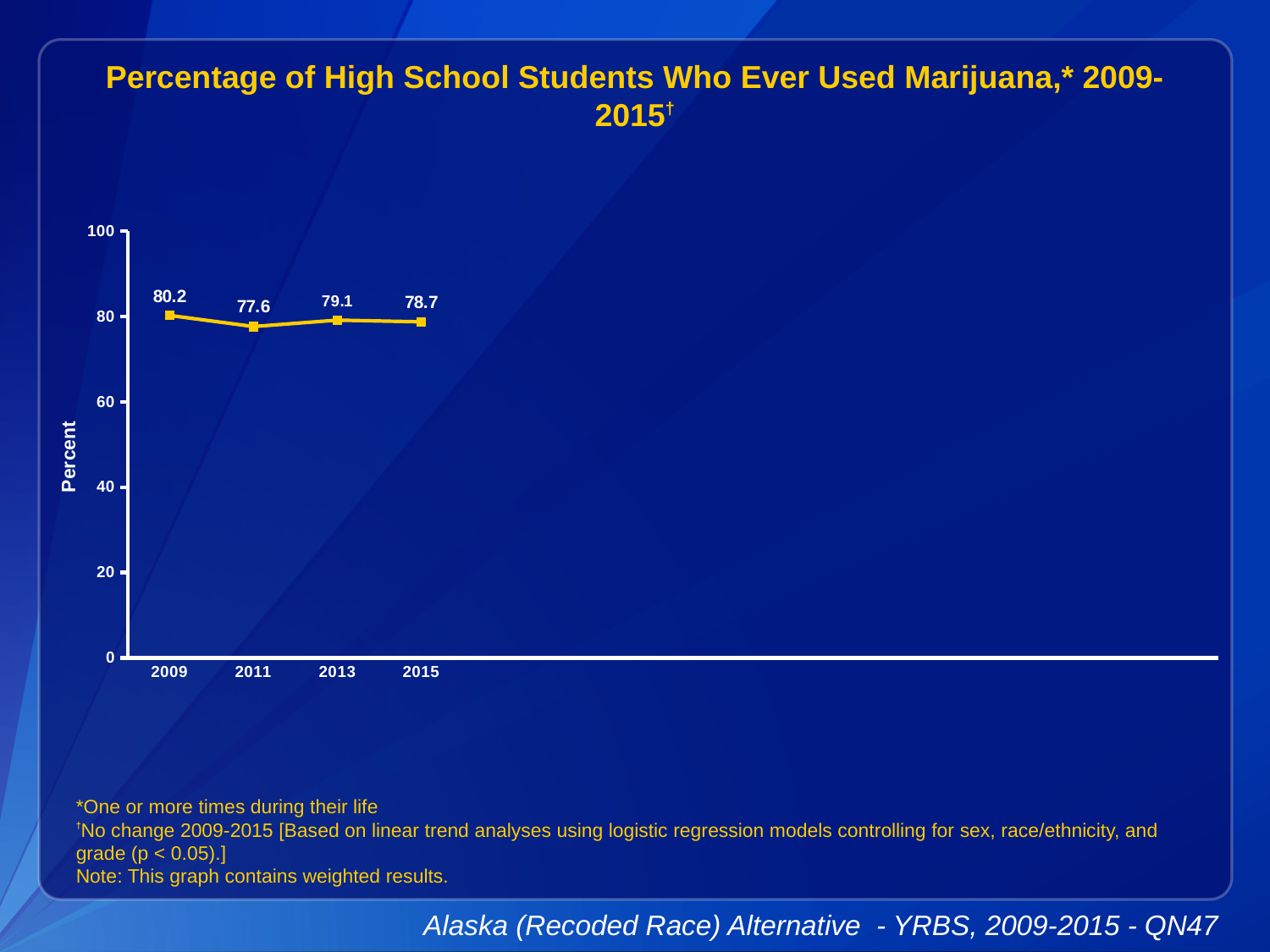
How many years are plotted on the chart? 4 What is the value for 2015? 78.7 Which year has the lowest value? 2011 What is the value for 2013? 79.1 Is the value for 2011 greater or less than 60? greater What is the difference between the values for 2009 and 2011? 2.6 Which year has the highest value? 2009 What is the value for 2009? 80.2 What is the label of the y axis? Percent Which is larger, the value for 2013 or the value for 2015? 2013 What kind of chart is shown on the slide? line chart What is the value for 2011? 77.6